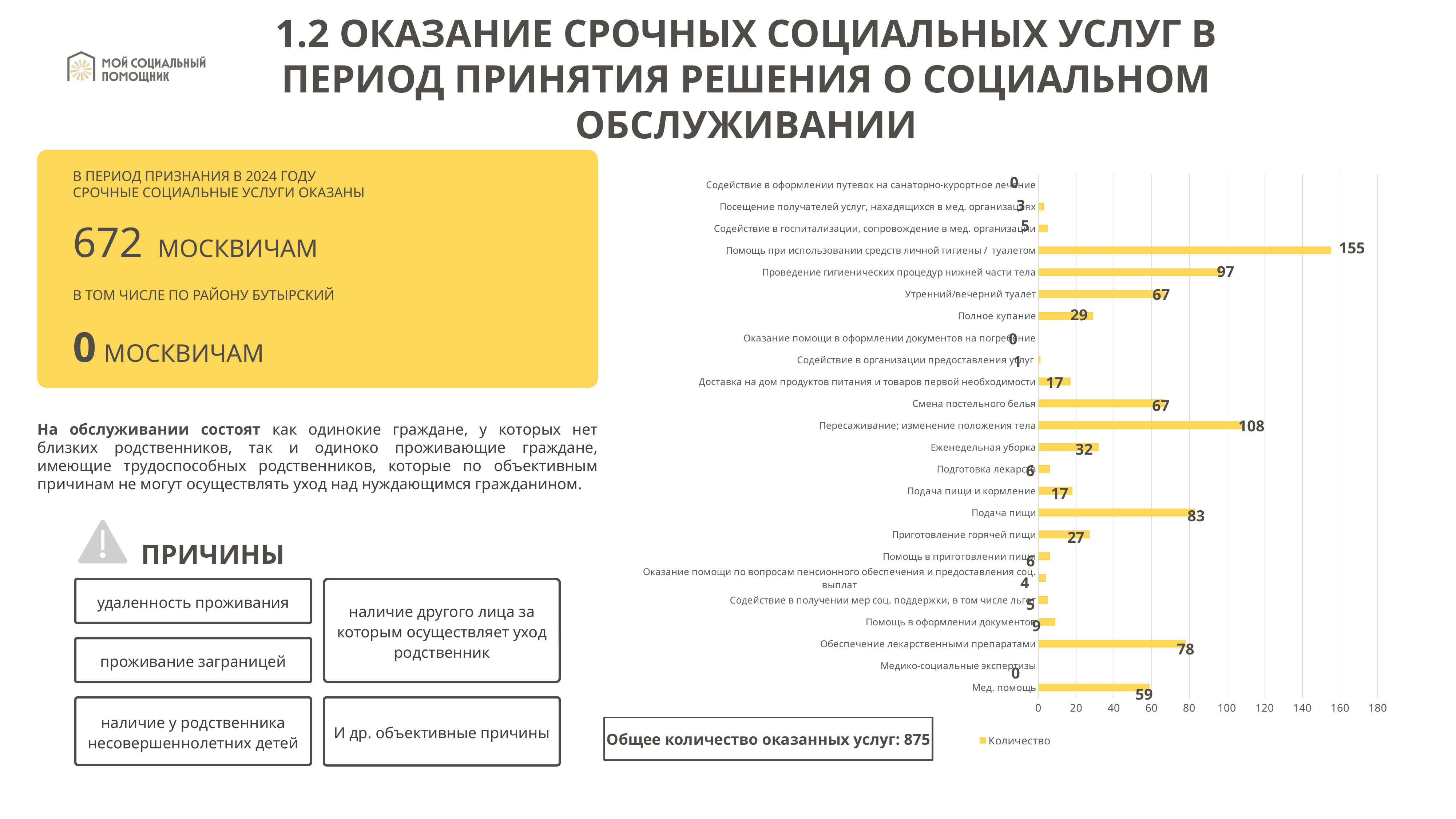
What is the value for "Помощь при использовании средств личной гигиены / туалетом"? 155 How many categories are shown in the chart? 24 What kind of chart is shown on the slide? bar chart How many series does the chart legend list? 1 What is the name of the series shown in the chart legend? Количество What is the value for "Обеспечение лекарственными препаратами"? 78 What is the difference between the values for "Проведение гигиенических процедур нижней части тела" and "Полное купание"? 68 Which category has the highest value in the chart? Помощь при использовании средств личной гигиены / туалетом What is the value for "Мед. помощь"? 59 Is the value for "Пересаживание; изменение положения тела" greater or less than 100? greater What is the value for "Пересаживание; изменение положения тела"? 108 Which is larger: the value for "Подача пищи" or the value for "Обеспечение лекарственными препаратами"? Подача пищи